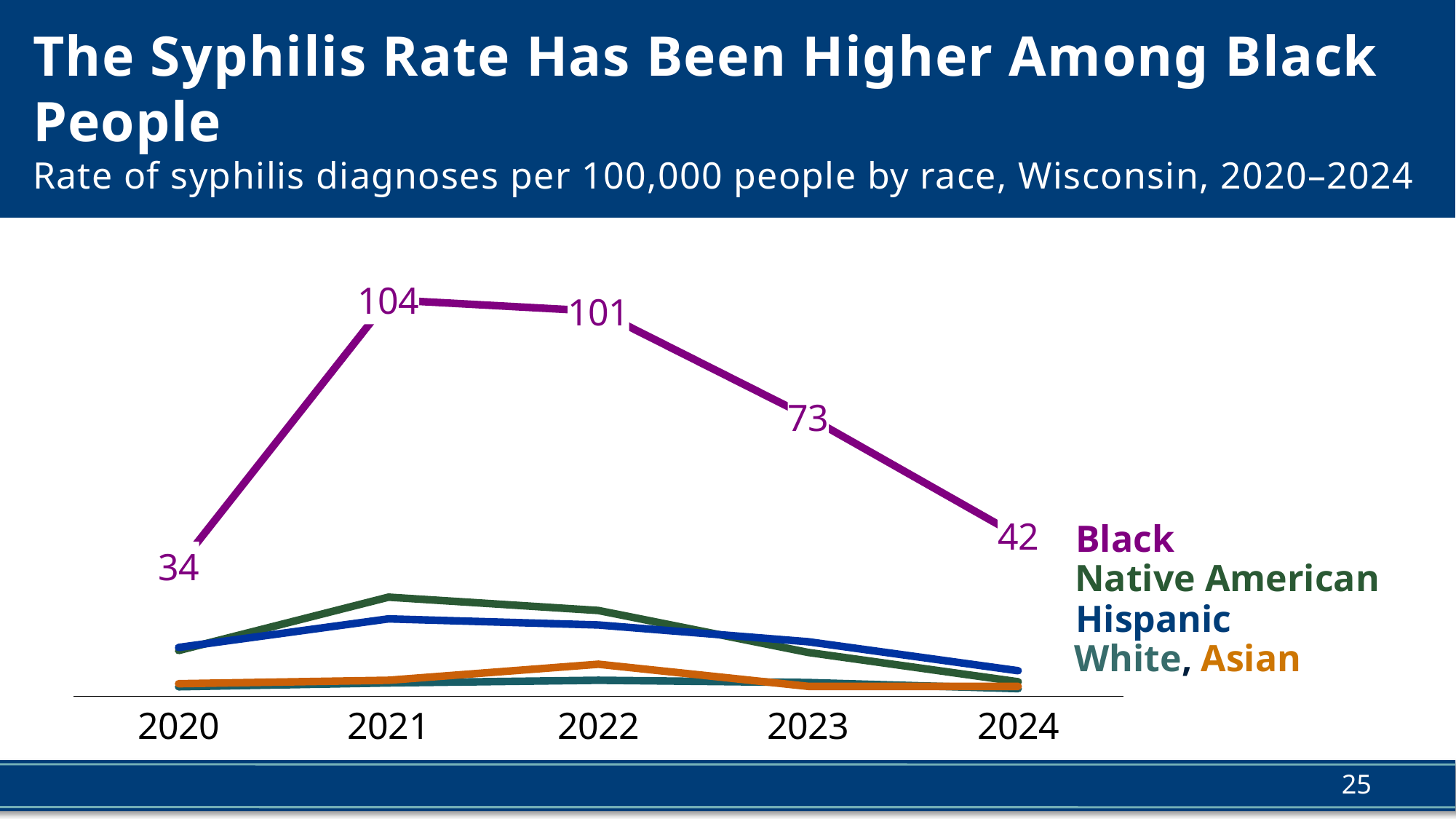
How many years are plotted on the x axis? 5 Which is larger, the Black rate in 2021 or in 2022? 2021 What type of chart is shown on the slide? line chart By how much did the syphilis rate among Black people fall from 2022 to 2023? 28 In which year was the syphilis rate among Black people highest? 2021 Did the syphilis rate among Black people rise or fall from 2021 to 2024? fall What was the syphilis rate among Black people in 2021? 104 What was the syphilis rate among Black people in 2024? 42 What was the syphilis rate among Black people in 2020? 34 How many racial groups (series) does the legend list? 5 In which year was the syphilis rate among Black people lowest? 2020 What was the syphilis rate among Black people in 2023? 73